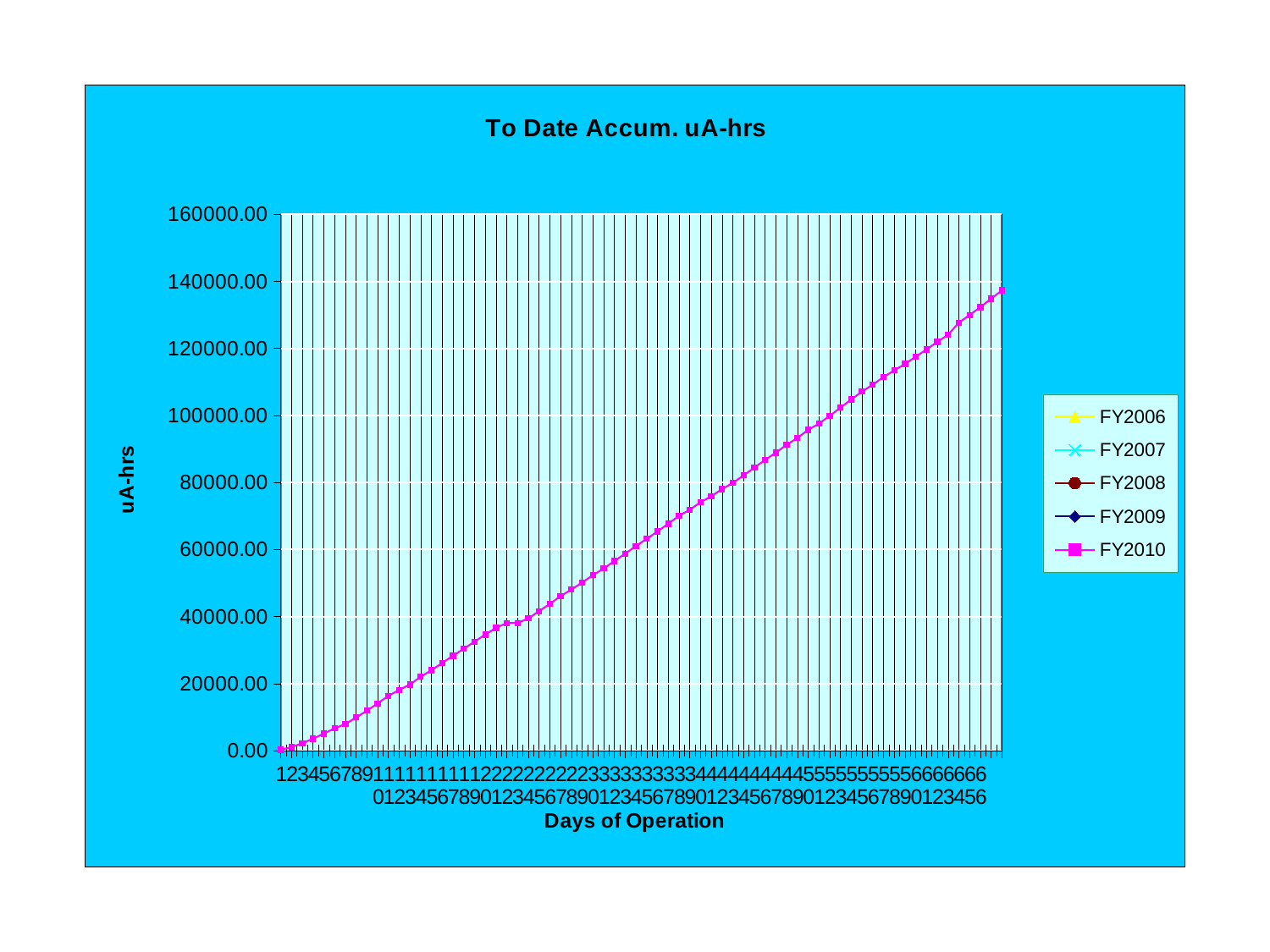
What is the title of the chart? To Date Accum. uA-hrs How many series does the legend list? 5 Is the value for day 66 greater or less than 120000.00? greater Do the plotted values rise or fall as the days of operation increase? rise What is the label of the x axis? Days of Operation Is the value for day 10 greater or less than 20000.00? less Is the value for day 66 greater or less than 140000.00? less Which day of operation has the lowest plotted value? 1 What kind of chart is shown on the slide? line chart